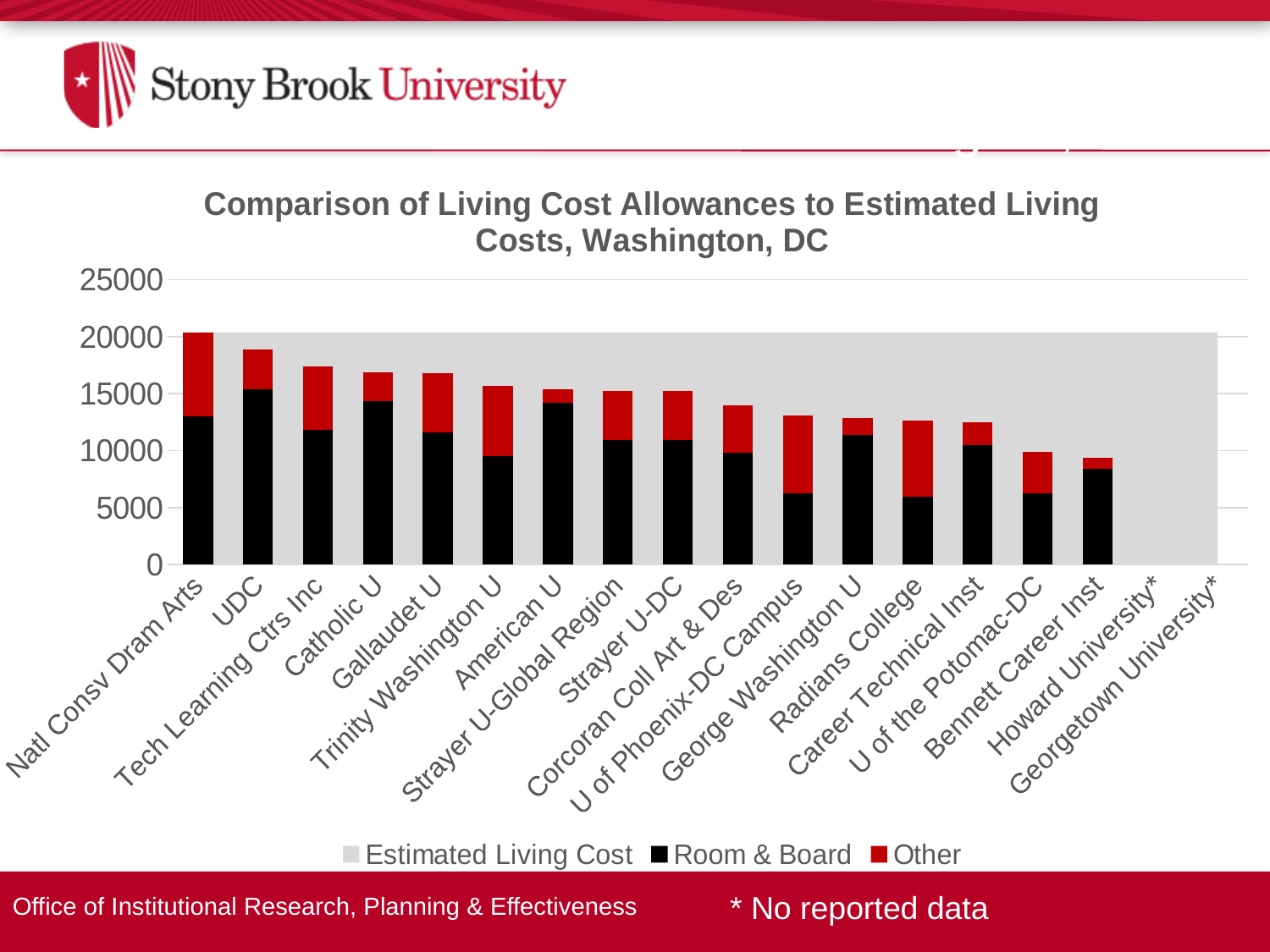
Is the total allowance for Bennett Career Inst greater or less than 10000? less Is the total allowance for UDC greater or less than 20000? less How many series does the legend list? 3 Which institution has the highest total living cost allowance (Room & Board plus Other)? Natl Consv Dram Arts What kind of chart is shown on the slide? Stacked bar chart Which two institutions are marked with an asterisk as having no reported data? Howard University and Georgetown University Is the Room & Board allowance for Radians College greater or less than 5000? greater How many institutions are labelled on the x axis? 18 Which institution has the largest Room & Board allowance? UDC Which has the larger Room & Board allowance, UDC or Natl Consv Dram Arts? UDC Do the total allowances generally rise or fall moving from left to right along the x axis? fall